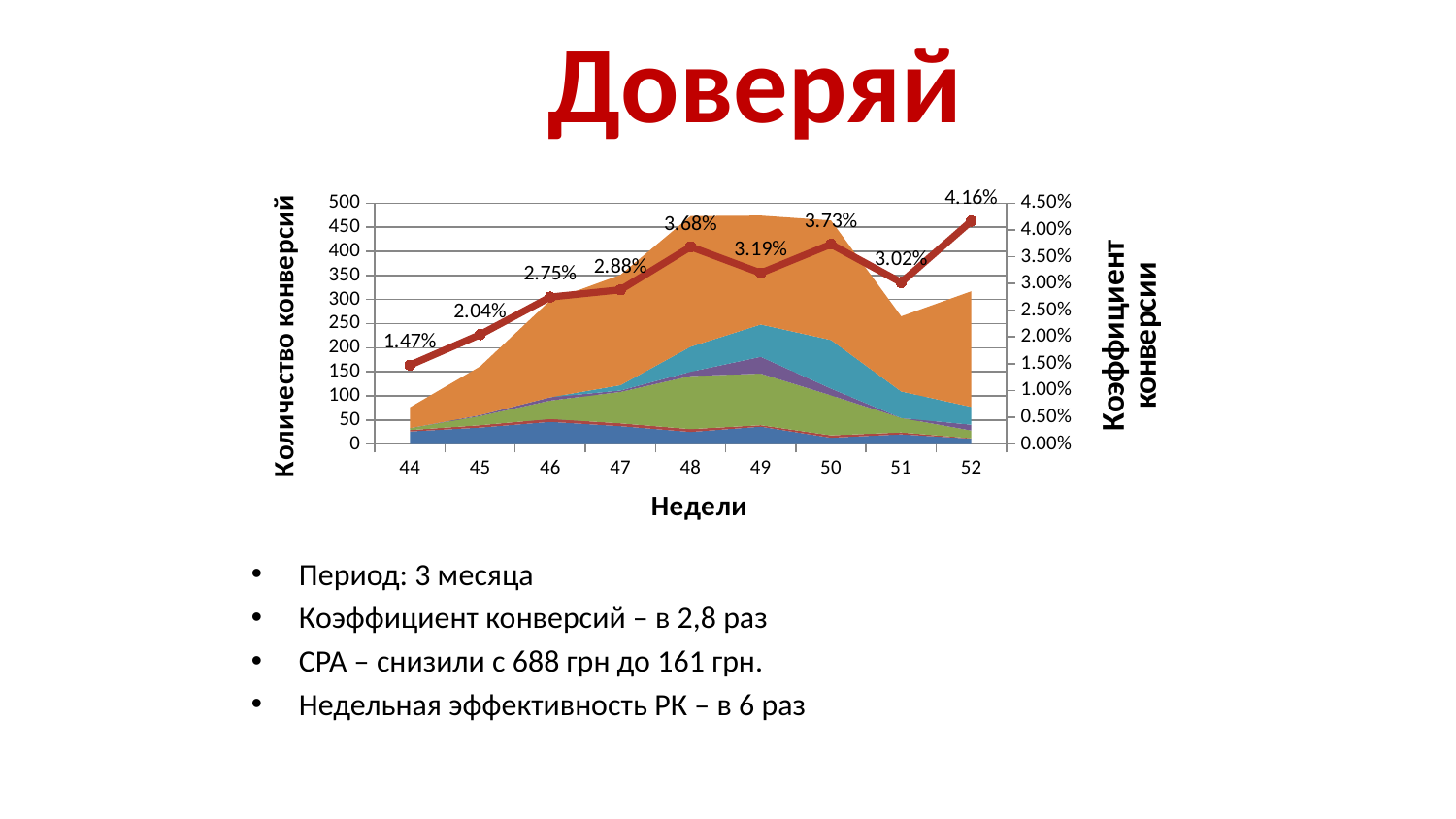
Is the total number of conversions (top of the stacked area) in week 49 greater or less than 400? greater What is the conversion rate shown for week 48? 3.68% Is the total number of conversions (top of the stacked area) in week 44 greater or less than 100? less Which week has the lowest conversion rate on the line? 44 Which week has the highest conversion rate on the line? 52 How many weeks are shown on the x axis? 9 What is the conversion rate shown for week 44? 1.47% Which week has a higher conversion rate, week 49 or week 50? 50 What is the title of the left vertical axis? Количество конверсий What is the difference between the conversion rate in week 52 and in week 44? 2.69% Does the conversion rate line generally rise or fall from week 44 to week 52? rise What is the conversion rate shown for week 51? 3.02%